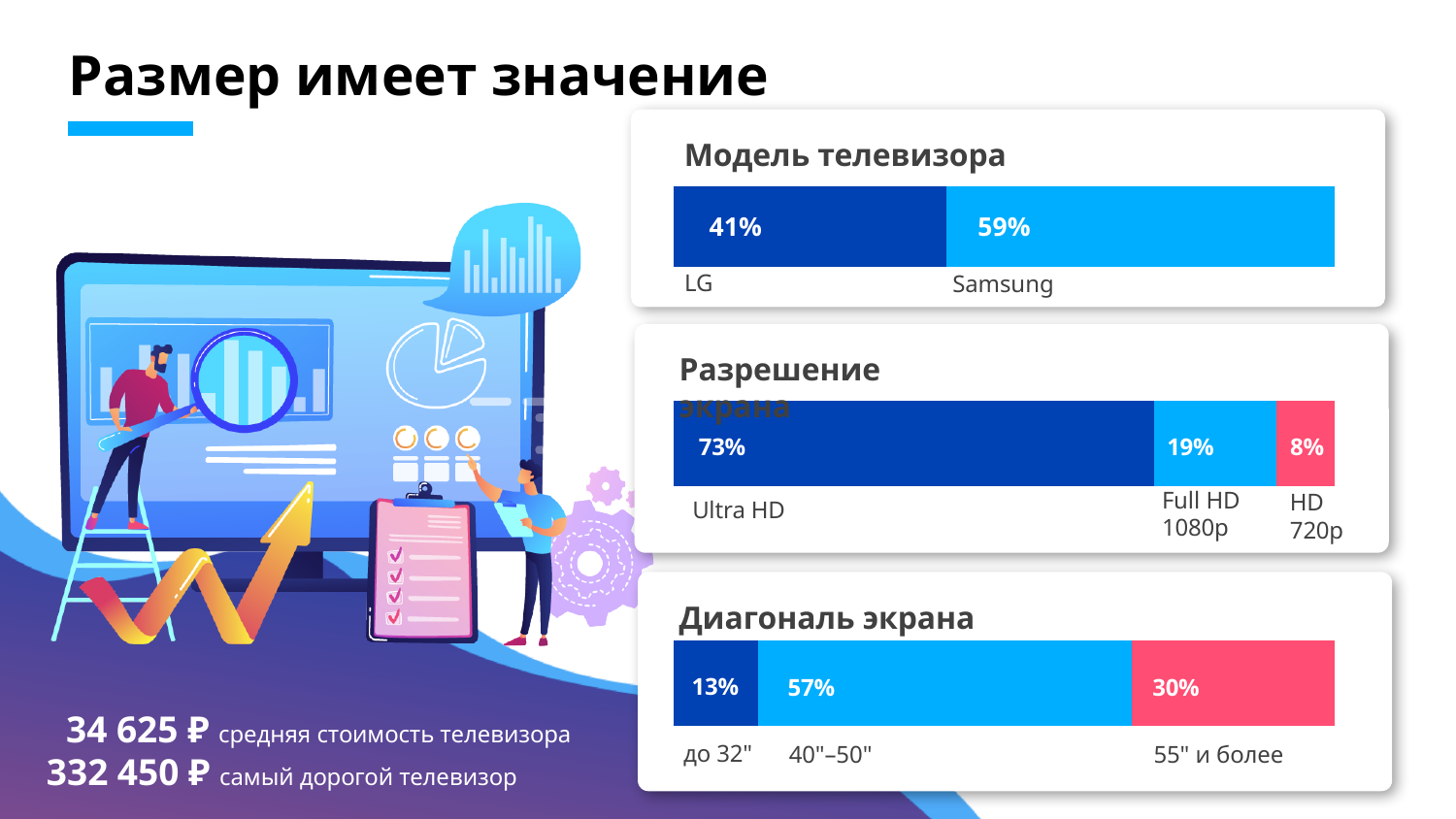
In the chart titled "Диагональ экрана", what is the value for 40"–50"? 57% In the chart titled "Модель телевизора", what is the value for LG? 41% In the chart titled "Диагональ экрана", which category has the highest value? 40"–50" In the chart titled "Модель телевизора", what is the difference between the Samsung and LG values? 18% In the chart titled "Диагональ экрана", what is the difference between the values for 55" и более and до 32"? 17% In the chart titled "Разрешение экрана", what is the value for Ultra HD? 73% In the chart titled "Модель телевизора", what is the value for Samsung? 59% In the chart titled "Модель телевизора", which of the two brands has the larger share, LG or Samsung? Samsung In the chart titled "Разрешение экрана", which category has the lowest value? HD 720p In the chart titled "Разрешение экрана", how many categories are shown? 3 In the chart titled "Разрешение экрана", what is the value for HD 720p? 8% What kind of chart is used for "Диагональ экрана"? Stacked bar chart